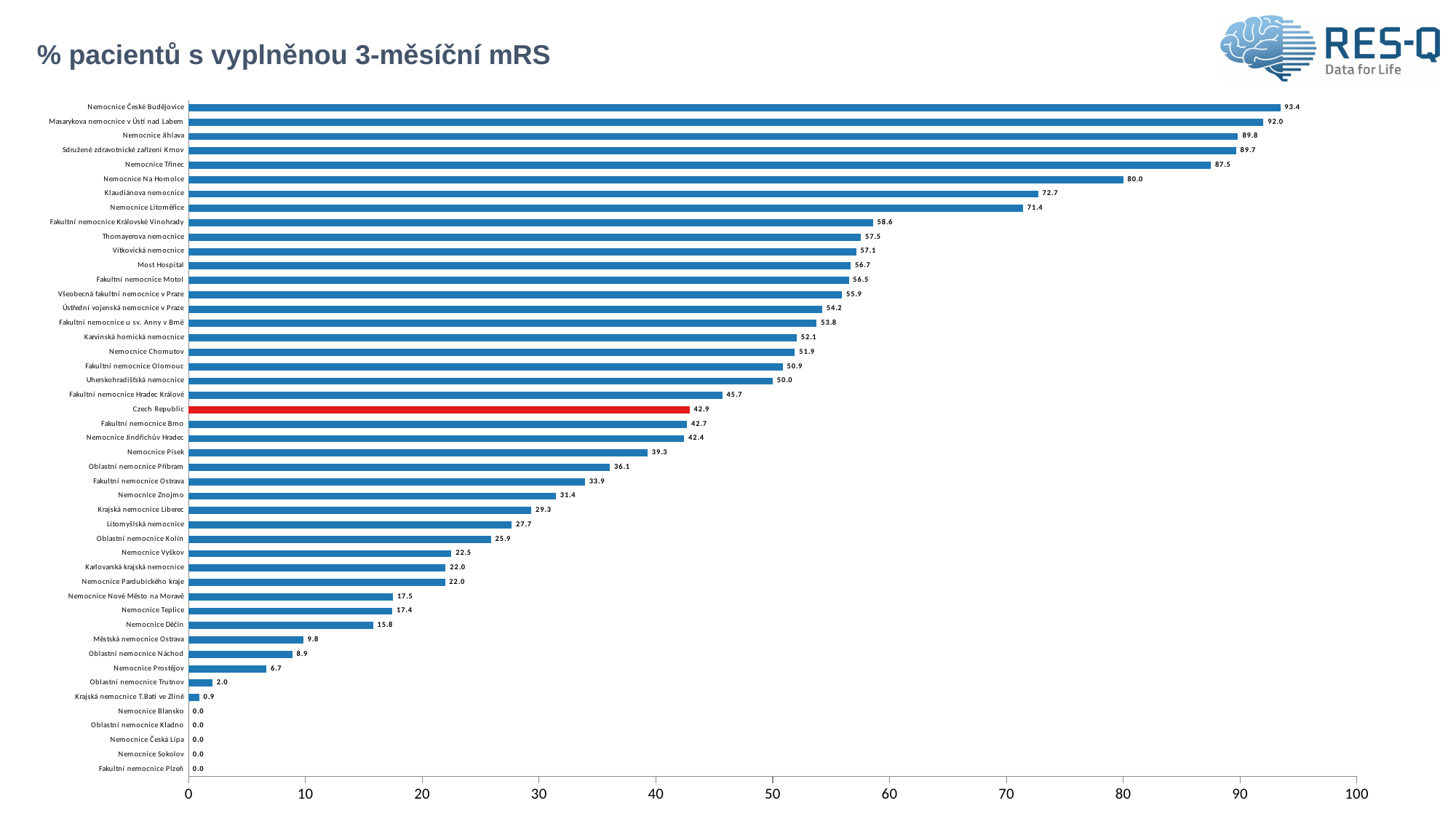
What is the difference between the values for Nemocnice Jihlava and Nemocnice Třinec? 2.3 What is the value for Czech Republic? 42.9 What is the value for Fakultní nemocnice Motol? 56.5 What is the title of the chart? % pacientů s vyplněnou 3-měsíční mRS How many hospitals have a value of 0.0? 5 What is the value for Nemocnice Prostějov? 6.7 Which hospital has the highest value? Nemocnice České Budějovice What kind of chart is shown on the slide? bar chart Is the value for Nemocnice Znojmo greater or less than 30? greater What is the value for Nemocnice České Budějovice? 93.4 What is the difference between the values for Nemocnice Na Homolce and Czech Republic? 37.1 Which is larger, the value for Klaudiánova nemocnice or the value for Fakultní nemocnice Královské Vinohrady? Klaudiánova nemocnice